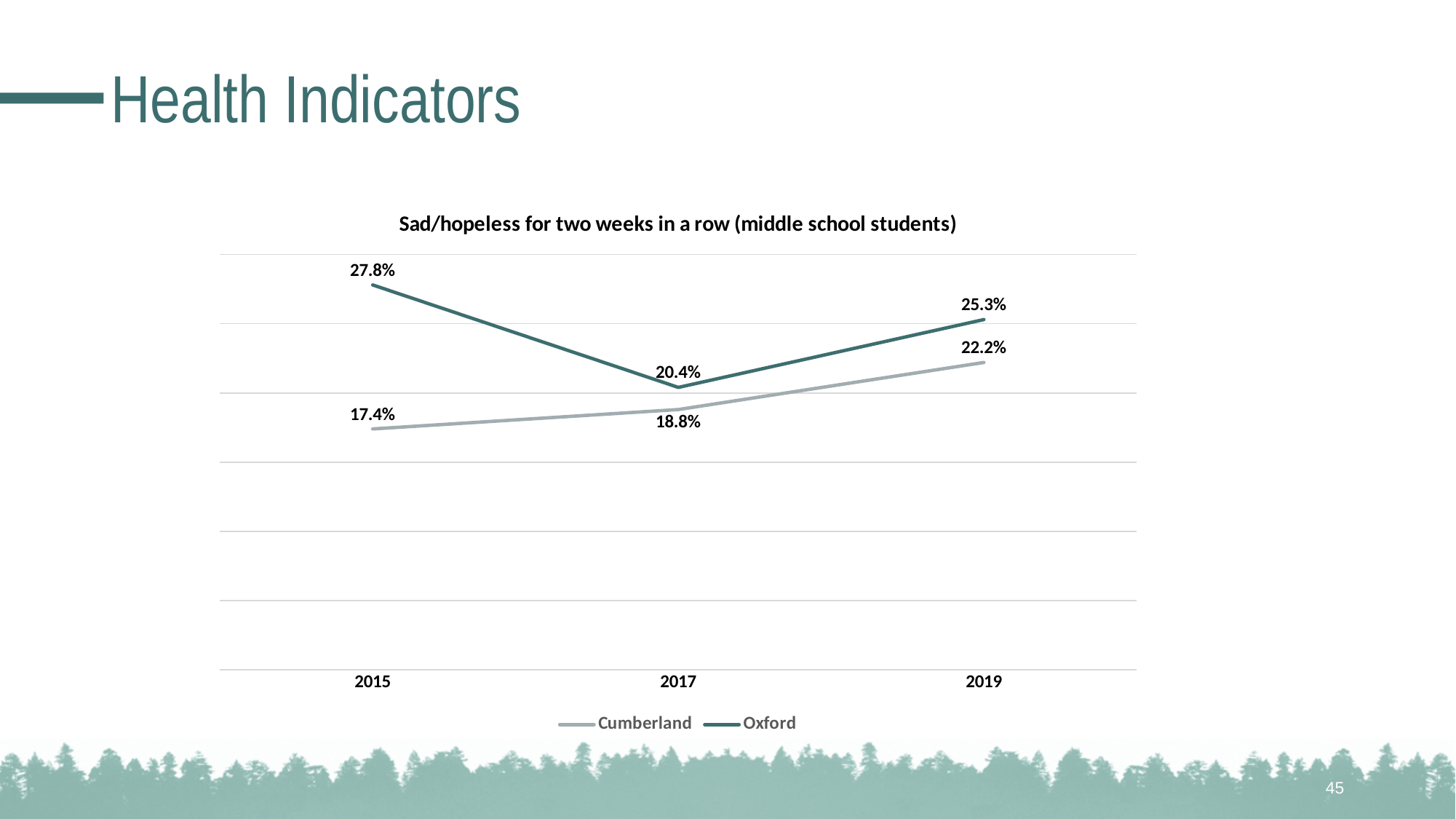
How many years are shown on the x axis? 3 How many series does the legend list? 2 Does the Cumberland line rise or fall from 2015 to 2019? Rise In which year is the Oxford value highest? 2015 What is the difference between the Oxford and Cumberland values in 2015? 10.4% What is the Oxford value for 2017? 20.4% What is the Oxford value for 2015? 27.8% In which year is the Cumberland value lowest? 2015 What kind of chart is this? Line chart Which is larger in 2019, the Oxford value or the Cumberland value? Oxford What is the Cumberland value for 2019? 22.2% What is the Cumberland value for 2017? 18.8%